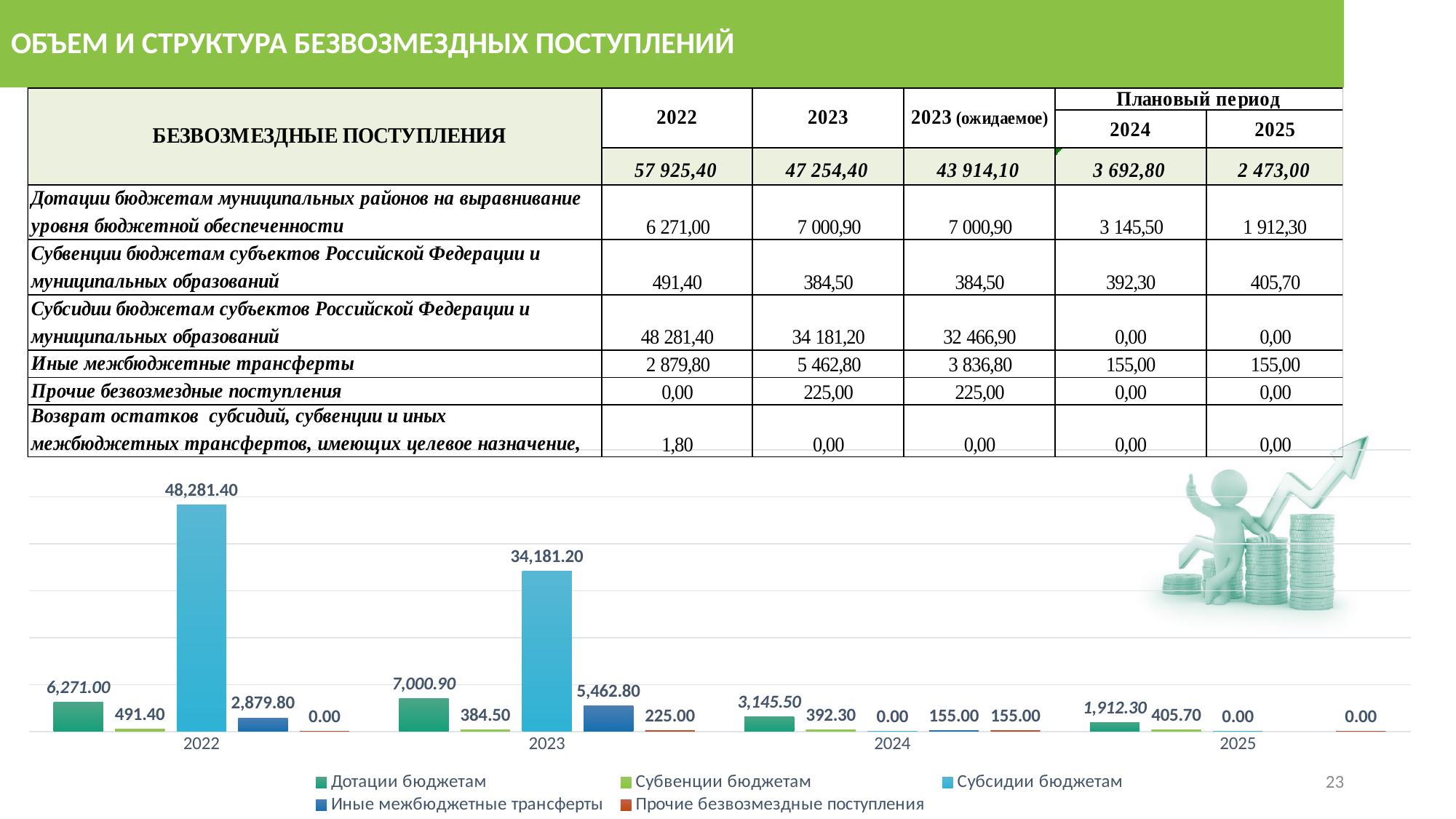
In which year is the Субсидии бюджетам bar highest? 2022 How many series does the chart legend list? 5 Do the Дотации бюджетам values rise or fall from 2023 to 2025? fall What is the value of Субвенции бюджетам for 2025 in the chart? 405.70 What is the value of Субсидии бюджетам for 2022 in the chart? 48,281.40 What is the value of Прочие безвозмездные поступления for 2023 in the chart? 225.00 What is the difference between Субсидии бюджетам in 2022 and in 2023? 14,100.20 How many year categories are shown on the x axis of the chart? 4 By how much did Дотации бюджетам increase from 2022 to 2023 according to the chart? 729.90 What kind of chart is shown at the bottom of the slide? bar chart What is the value of Дотации бюджетам for 2023 in the chart? 7,000.90 Which year has the larger value for Иные межбюджетные трансферты, 2022 or 2023? 2023